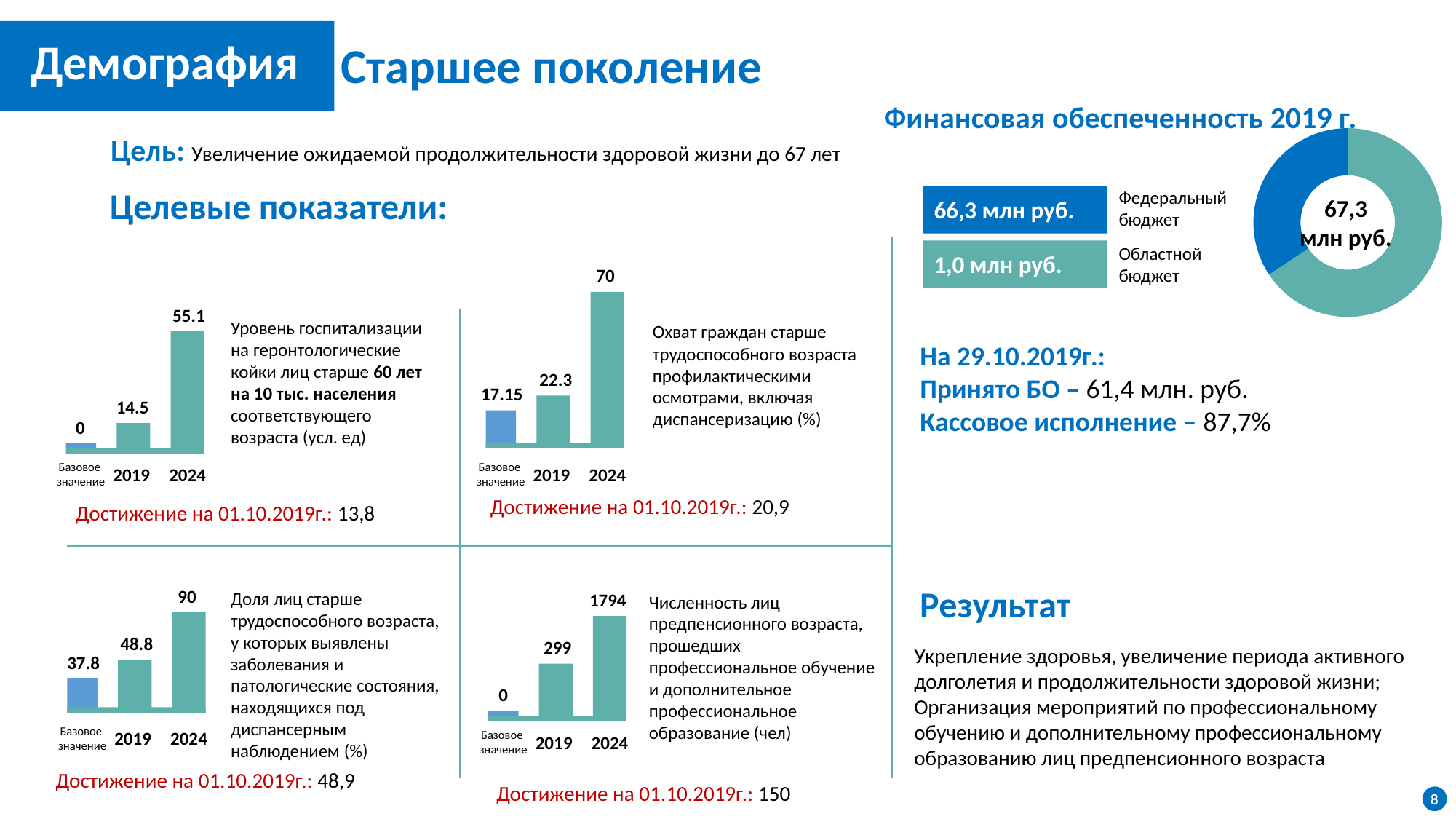
In the Финансовая обеспеченность 2019 г. chart, what is the total shown in the centre? 67,3 млн руб. What kind of chart is used for Финансовая обеспеченность 2019 г.? Donut chart In the top-left bar chart (Уровень госпитализации на геронтологические койки), what is the value for 2024? 55.1 In the top-middle bar chart (Охват граждан старше трудоспособного возраста профилактическими осмотрами), which category has the highest value? 2024 In the Финансовая обеспеченность 2019 г. chart, what is the value for Федеральный бюджет? 66,3 млн руб. In the top-left bar chart (Уровень госпитализации на геронтологические койки), what is the value for 2019? 14.5 In the bottom-left bar chart (Доля лиц старше трудоспособного возраста под диспансерным наблюдением), which category has the lowest value? Базовое значение In the bottom-left bar chart (Доля лиц старше трудоспособного возраста под диспансерным наблюдением), what is the difference between the 2024 and 2019 values? 41.2 In the bottom-middle bar chart (Численность лиц предпенсионного возраста, прошедших профессиональное обучение), what is the value for 2024? 1794 How many categories are shown in the top-left bar chart (Уровень госпитализации на геронтологические койки)? 3 In the bottom-middle bar chart (Численность лиц предпенсионного возраста, прошедших профессиональное обучение), is the value for 2019 larger or smaller than the value for 2024? smaller In the top-middle bar chart (Охват граждан старше трудоспособного возраста профилактическими осмотрами), what is the value for Базовое значение? 17.15